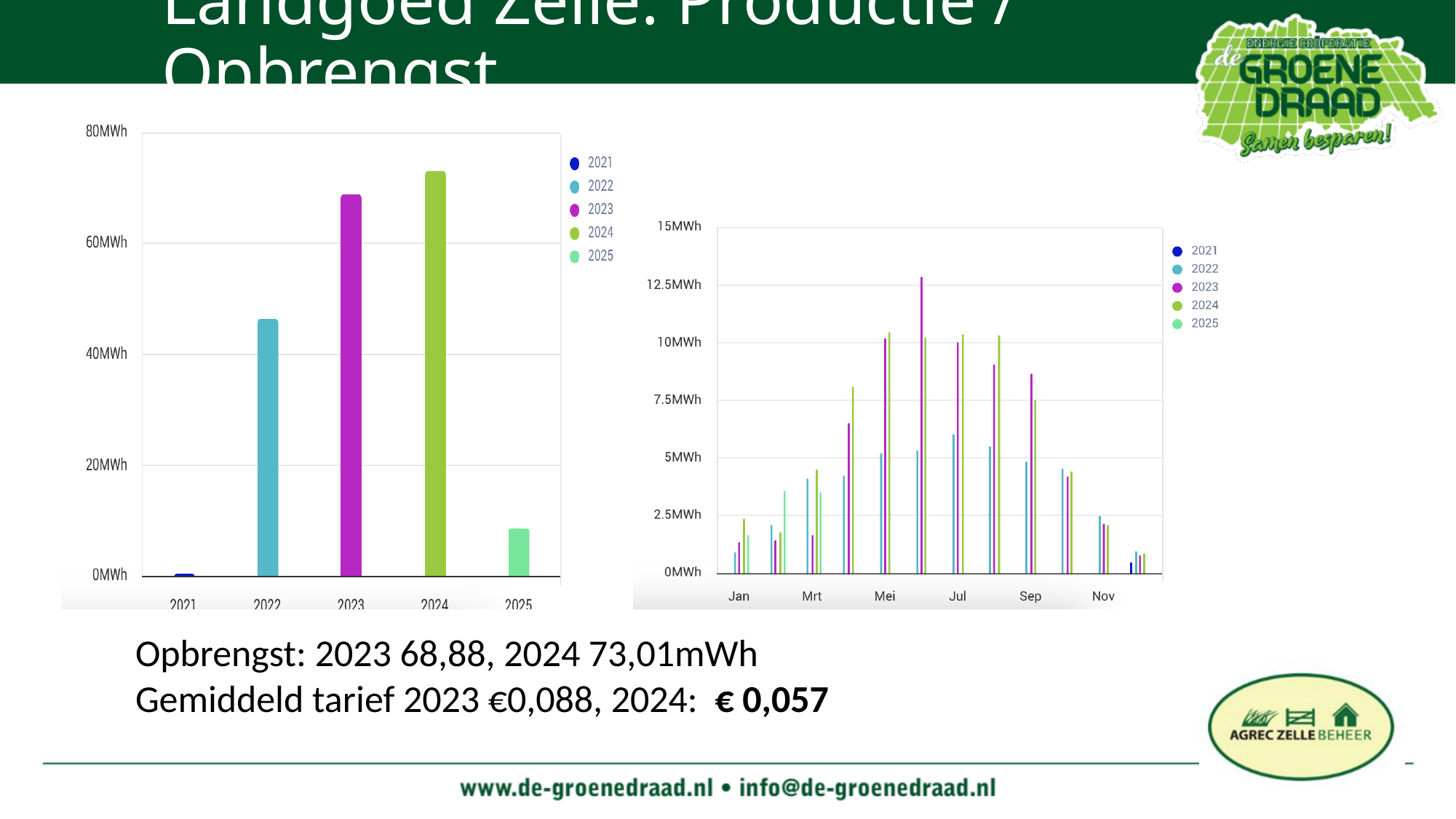
What kind of chart is the left chart showing yearly production? bar chart According to the text below the charts, what was the Opbrengst for 2024? 73,01mWh In the left chart, which is larger, the bar for 2023 or the bar for 2022? 2023 In the right monthly chart, which series has the tallest bar overall? 2023 In the left chart, which year has the highest bar? 2024 In the right monthly chart, is the value for 2023 in Mrt greater or less than 5MWh? less In the left chart, is the value for 2025 greater or less than 20MWh? less How many years are shown on the x axis of the left chart? 5 According to the text below the charts, how much higher is the 2024 Opbrengst (73,01) than the 2023 Opbrengst (68,88)? 4,13 mWh How many series does the legend of the left chart list? 5 In the left chart, which year has the lowest bar? 2021 In the left chart, is the value for 2022 greater or less than 40MWh? greater